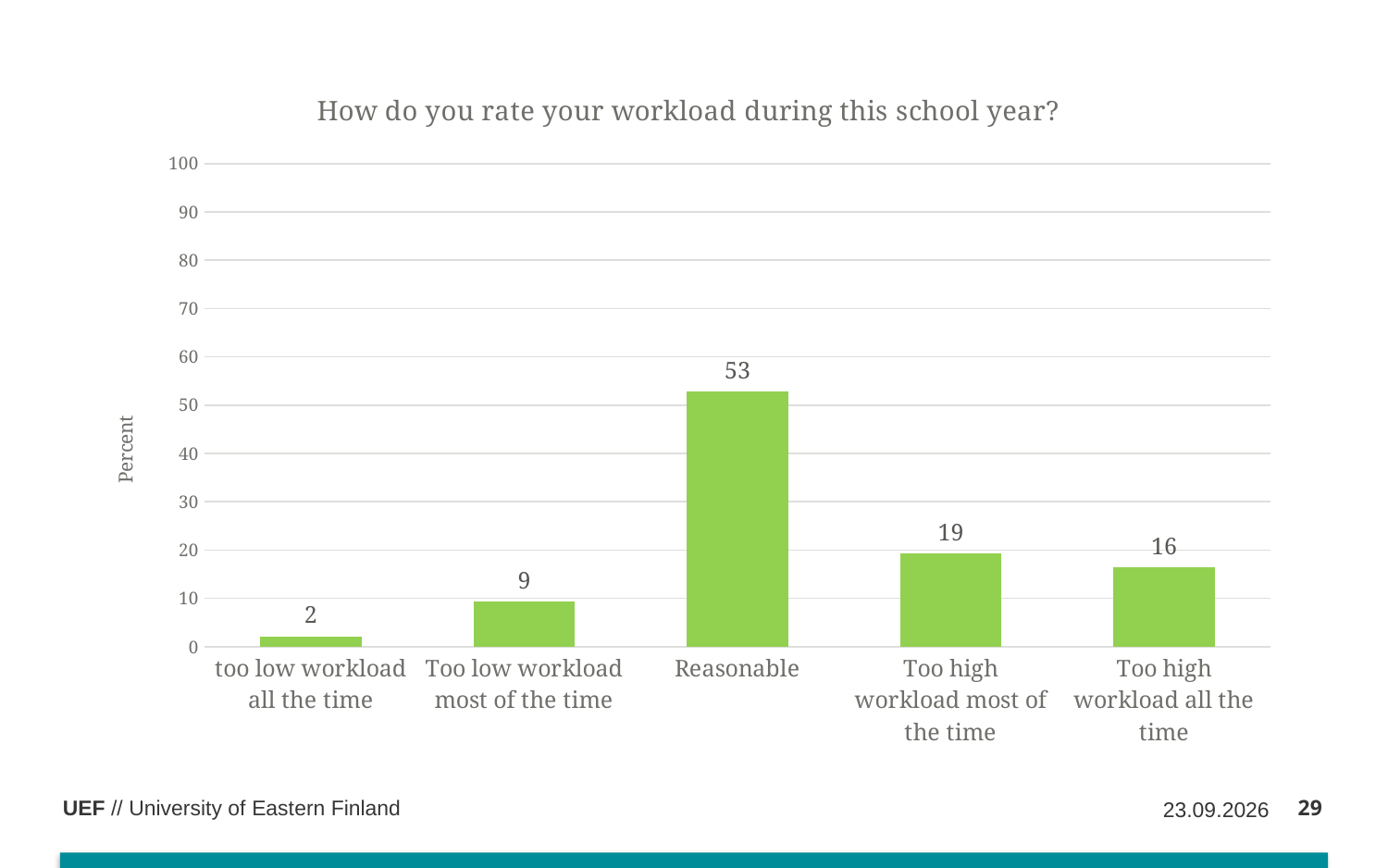
Is the value for Too high workload all the time greater or less than 20? less Which is larger, the value for Too low workload most of the time or the value for Too high workload all the time? Too high workload all the time What is the value for Reasonable? 53 Which category has the lowest value? too low workload all the time What is the title of the chart? How do you rate your workload during this school year? What is the difference between the values for Reasonable and Too high workload most of the time? 34 How many categories are shown on the x axis? 5 What is the value for Too high workload most of the time? 19 What is the value for too low workload all the time? 2 Which category has the highest value? Reasonable What is the label of the y axis? Percent What kind of chart is shown on the slide? bar chart